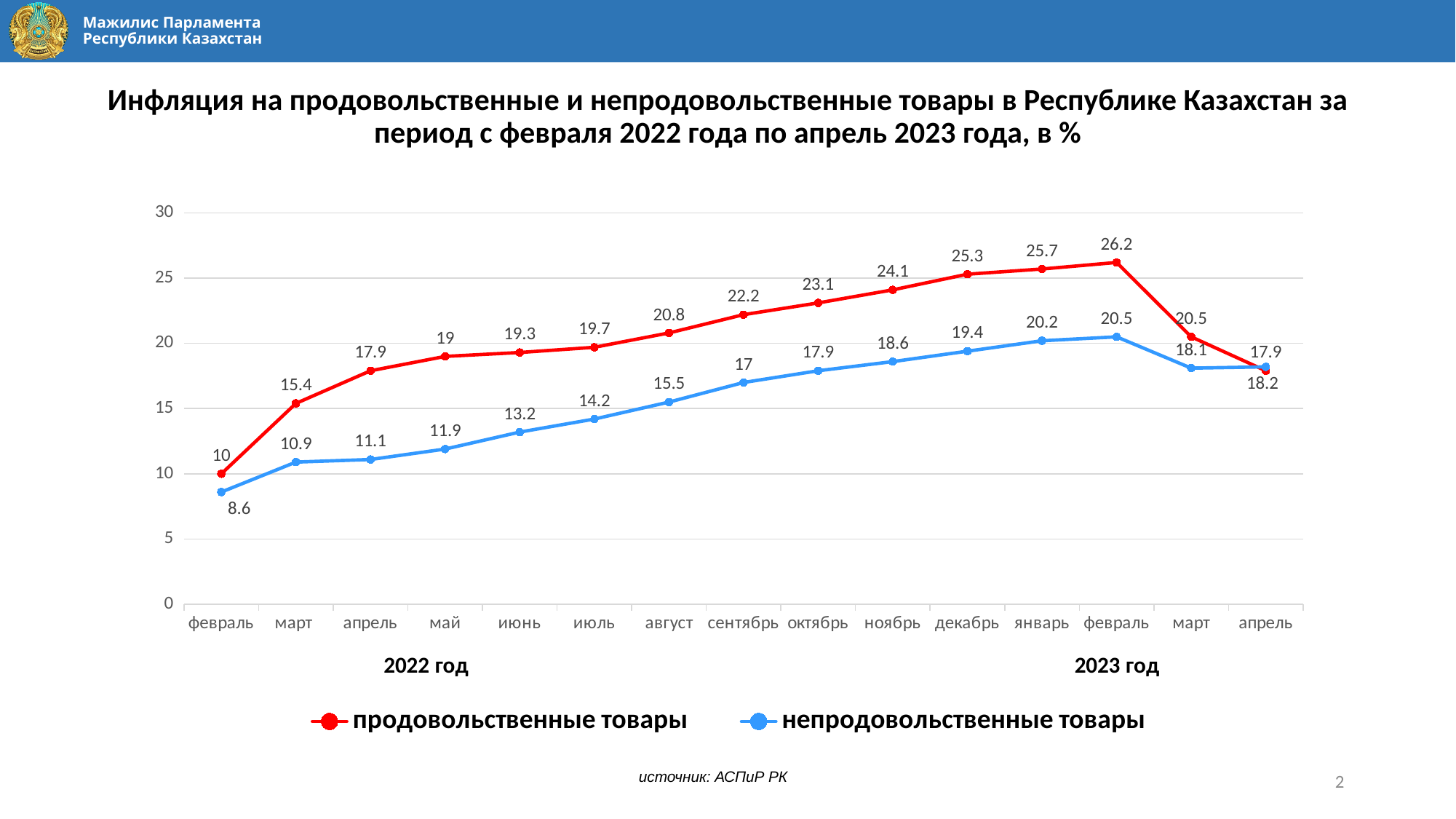
In which month does продовольственные товары reach its highest value? февраль 2023 In which month does непродовольственные товары reach its highest value? февраль 2023 How many months are plotted along the x axis? 15 In март 2023, which series has the larger value, продовольственные товары or непродовольственные товары? продовольственные товары What is the value for продовольственные товары in февраль 2022? 10 In which month is the value for продовольственные товары lowest? февраль 2022 What kind of chart is shown on the slide? line chart How many series does the legend list? 2 What is the value for непродовольственные товары in сентябрь 2022? 17 Does the value for продовольственные товары rise or fall from февраль 2022 to февраль 2023? rise What is the value for непродовольственные товары in февраль 2022? 8.6 What is the difference between продовольственные товары and непродовольственные товары in январь 2023? 5.5